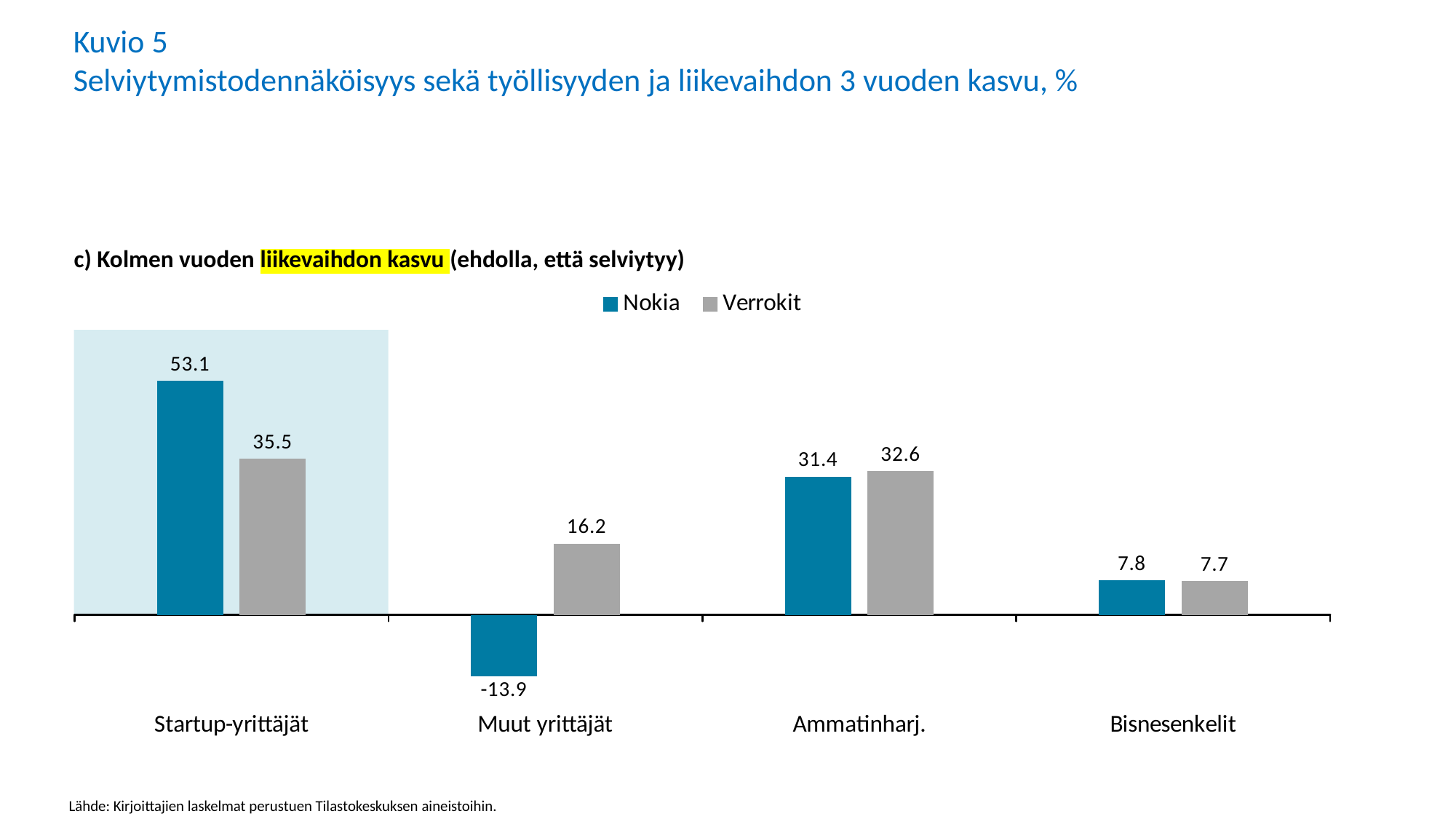
What is the Verrokit value for Muut yrittäjät? 16.2 Which category has the lowest Nokia value? Muut yrittäjät What is the Verrokit value for Ammatinharj.? 32.6 How many categories are shown on the x axis? 4 For Muut yrittäjät, which series has the larger value, Nokia or Verrokit? Verrokit What is the Nokia value for Startup-yrittäjät? 53.1 What kind of chart is shown? Bar chart Which category has the highest Nokia value? Startup-yrittäjät How many series does the legend list? 2 What is the difference between the Nokia and Verrokit values for Startup-yrittäjät? 17.6 What is the Nokia value for Muut yrittäjät? -13.9 Which category has the lowest Verrokit value? Bisnesenkelit